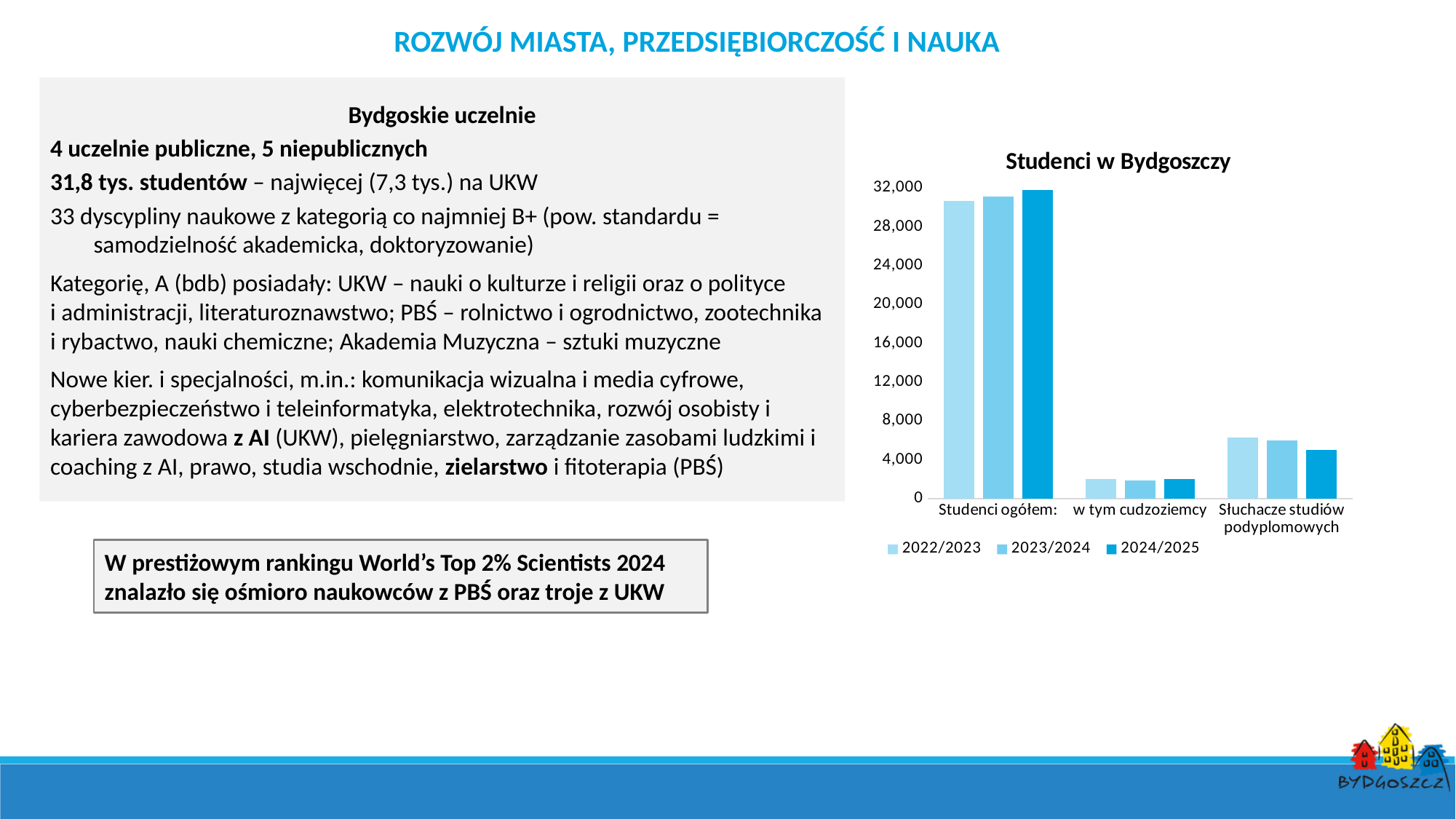
What is the title of the chart? Studenci w Bydgoszczy Which academic years are listed in the chart legend? 2022/2023, 2023/2024, 2024/2025 For Słuchacze studiów podyplomowych, which is larger: the 2022/2023 value or the 2024/2025 value? 2022/2023 What kind of chart is shown on the slide? bar chart How many categories are shown on the x axis of the chart? 3 How many series does the chart legend list? 3 Is the value for w tym cudzoziemcy in 2023/2024 greater or less than 4,000? less Which category has the lowest values in the chart? w tym cudzoziemcy Is the value for Słuchacze studiów podyplomowych in 2022/2023 greater or less than 4,000? greater Do the values for Słuchacze studiów podyplomowych rise or fall from 2022/2023 to 2024/2025? fall Which category has the highest values in the chart? Studenci ogółem: Is the value for Studenci ogółem in 2024/2025 greater or less than 28,000? greater